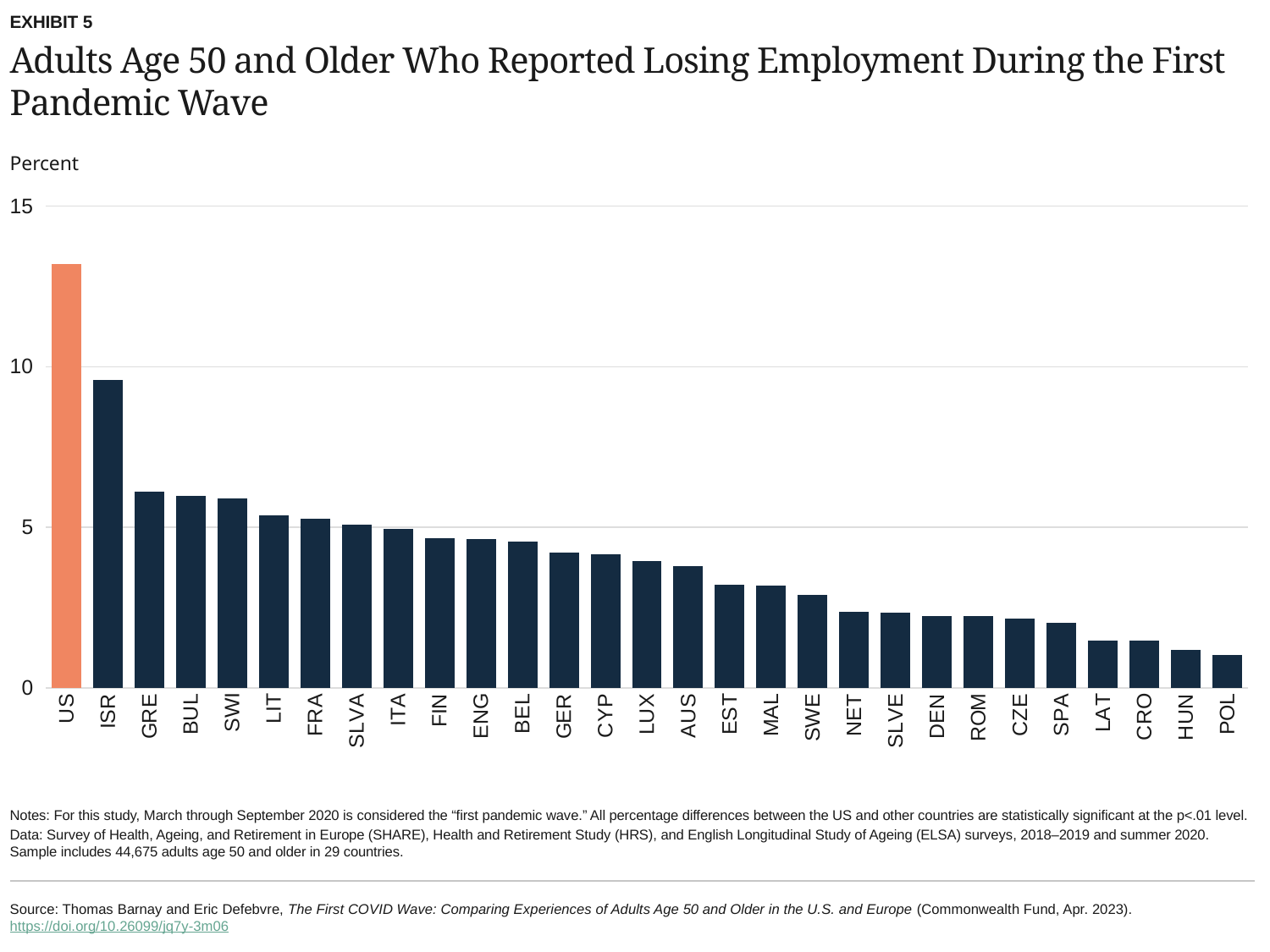
Which country has the highest share of adults age 50 and older who reported losing employment? US Is the value for GRE greater or less than 5? greater What kind of chart is shown on the slide? bar chart Is the value for GER greater or less than 5? less Is the value for ISR greater or less than 10? less Which country's bar is shown in orange rather than dark blue? US How many countries are shown on the x axis of the chart? 29 Which country has the lowest share of adults age 50 and older who reported losing employment? POL Which has a higher value, SPA or FRA? FRA Do the values rise or fall moving from left to right along the x axis? fall Which has a higher value, US or ISR? US